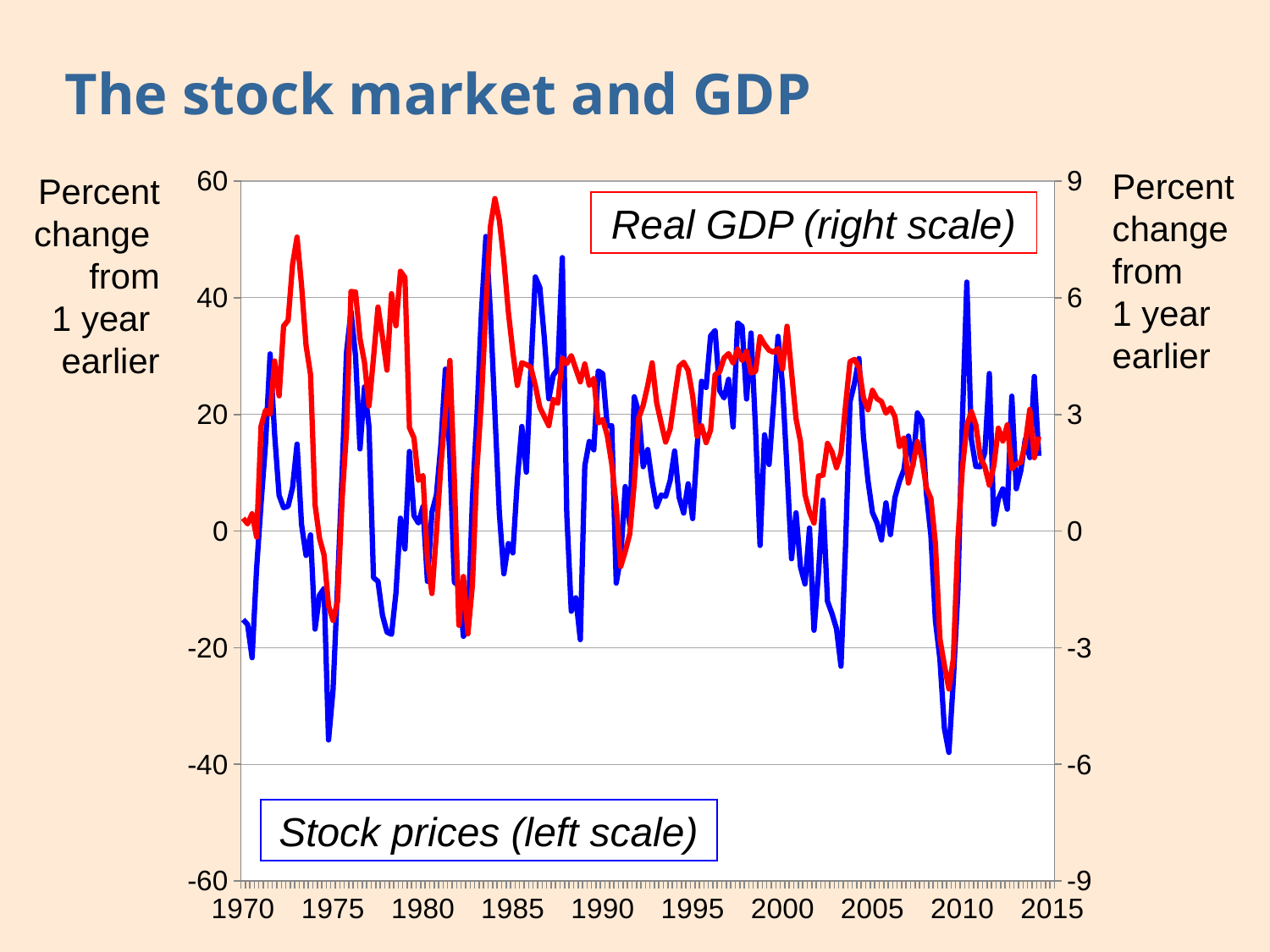
Is the value for Real GDP at its peak around 1984 greater or less than 6 on the right scale? greater Is the value for Stock prices at its lowest point around 2009 greater or less than -20? less Which series is plotted against the left scale? Stock prices What kind of chart is shown on the slide? line chart Is the value for Stock prices at its low point around 1975 greater or less than -20? less What is the title of the slide's chart? The stock market and GDP How many series are plotted on the chart? 2 What is the highest value shown on the right-hand axis? 9